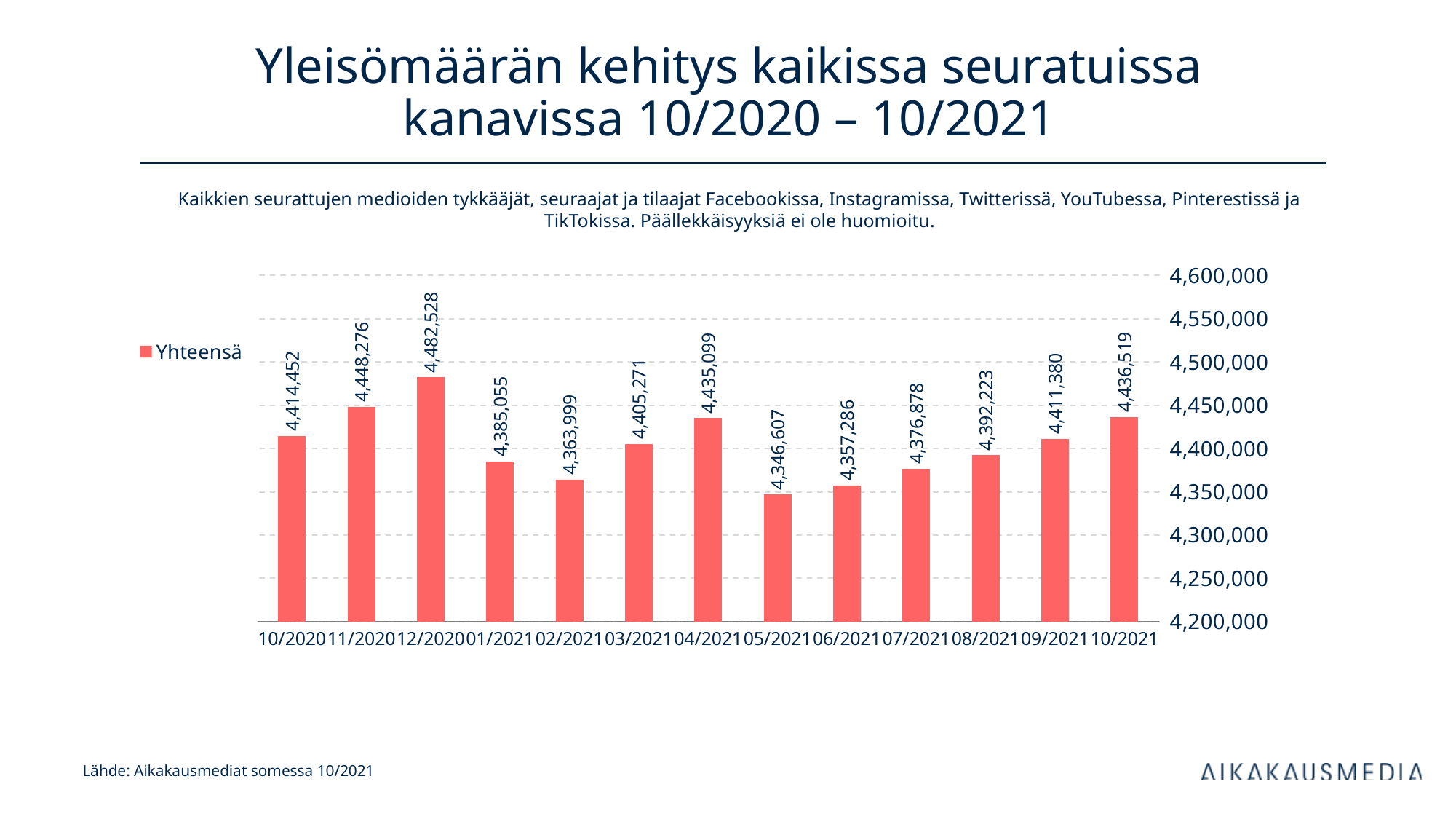
What kind of chart is shown on the slide? bar chart What is the value for 05/2021? 4,346,607 Which is larger, the value for 11/2020 or the value for 04/2021? 11/2020 Which month has the lowest value? 05/2021 How many series does the legend list? 1 Which month has the highest value? 12/2020 How many months are shown on the x axis? 13 What is the value for 12/2020? 4,482,528 What is the value for 10/2021? 4,436,519 What is the difference between the values for 12/2020 and 05/2021? 135,921 What is the difference between the values for 10/2021 and 10/2020? 22,067 Is the value for 02/2021 greater or less than 4,400,000? less